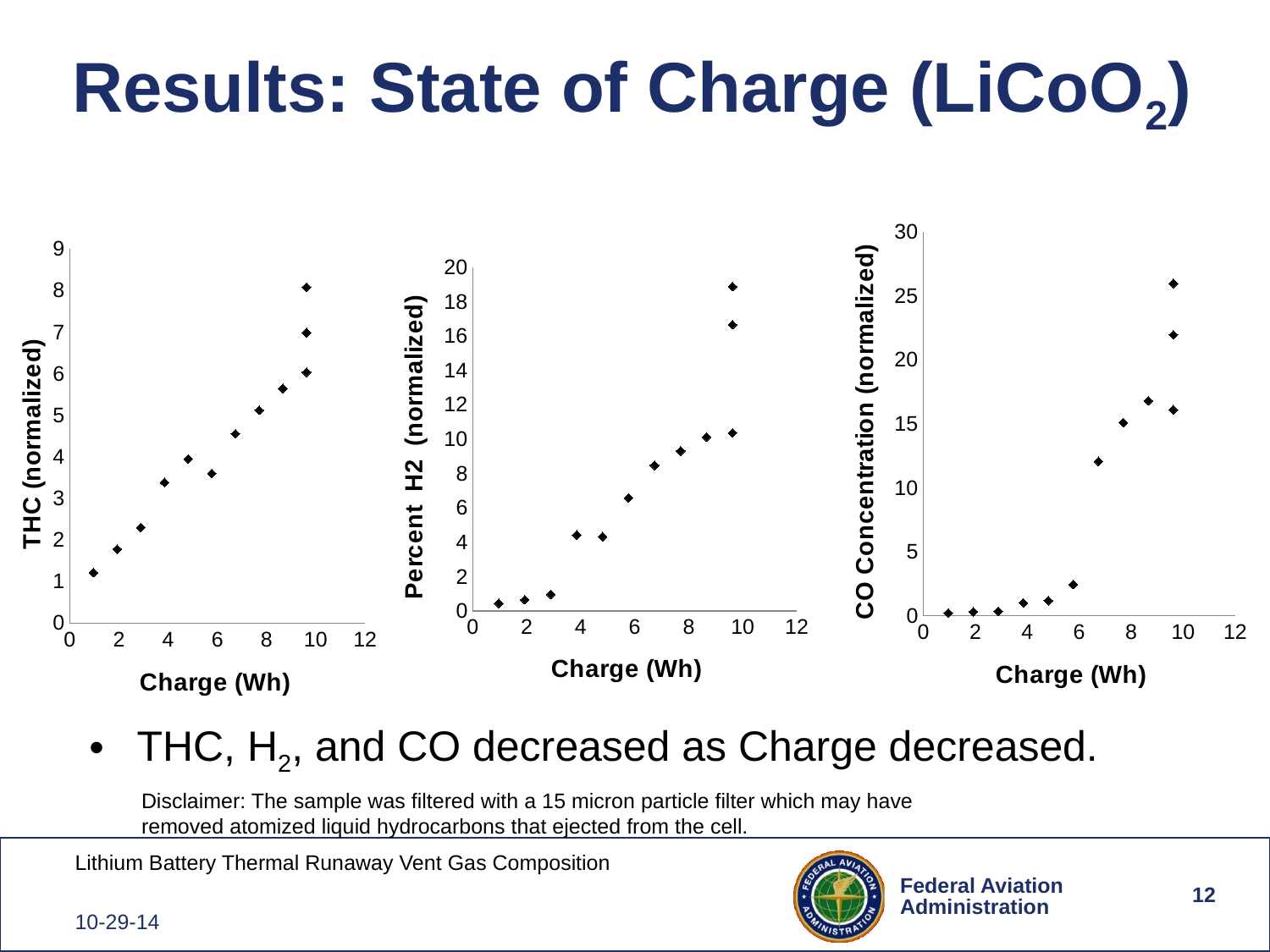
In the rightmost chart (CO Concentration (normalized)), is the value at a Charge of about 2 Wh greater or less than 5? less What is the x-axis label shared by all three charts? Charge (Wh) In the rightmost chart (CO Concentration (normalized)), do the values rise or fall as Charge (Wh) increases? rise In the leftmost chart (THC (normalized)), do the values rise or fall as Charge (Wh) increases? rise In the middle chart (Percent H2 (normalized)), is the highest plotted value greater or less than 15? greater What kind of chart is the leftmost chart (THC (normalized) vs Charge (Wh))? scatter chart In the middle chart (Percent H2 (normalized)), is the value at a Charge of about 2 Wh greater or less than 2? less In the middle chart (Percent H2 (normalized)), do the values rise or fall as Charge (Wh) increases? rise What is the y-axis label of the rightmost chart? CO Concentration (normalized) How many data points are plotted in the leftmost chart (THC (normalized))? 12